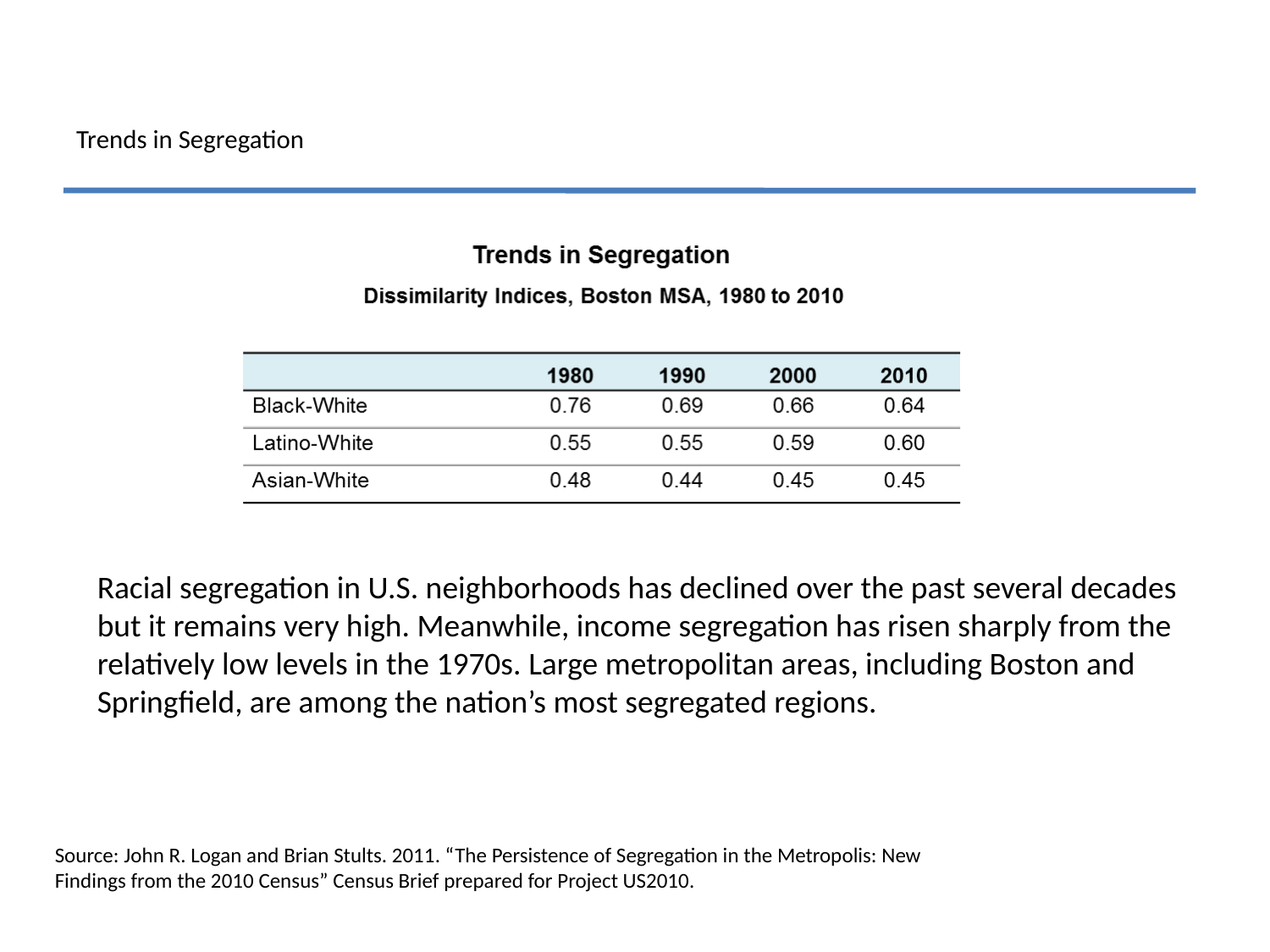
In the table, does the Latino-White dissimilarity index rise or fall from 1990 to 2010? rise In the table, what is the Latino-White dissimilarity index for 2010? 0.60 In the table, which group pairing has the highest dissimilarity index in 2010? Black-White In the table, what is the Asian-White dissimilarity index for 1990? 0.44 In the table, what is the difference between the Black-White index in 1980 and in 2010? 0.12 What is the subtitle of the table? Dissimilarity Indices, Boston MSA, 1980 to 2010 In the table, which is larger: the Latino-White index in 2010 or the Asian-White index in 2010? Latino-White In the table, does the Black-White dissimilarity index rise or fall from 1980 to 2010? fall In the table, which group pairing has the lowest dissimilarity index in 1980? Asian-White In the table, what is the difference between the Black-White and Latino-White indices in 2000? 0.07 In the table, what is the Black-White dissimilarity index for 1980? 0.76 How many years (columns) does the table report? 4